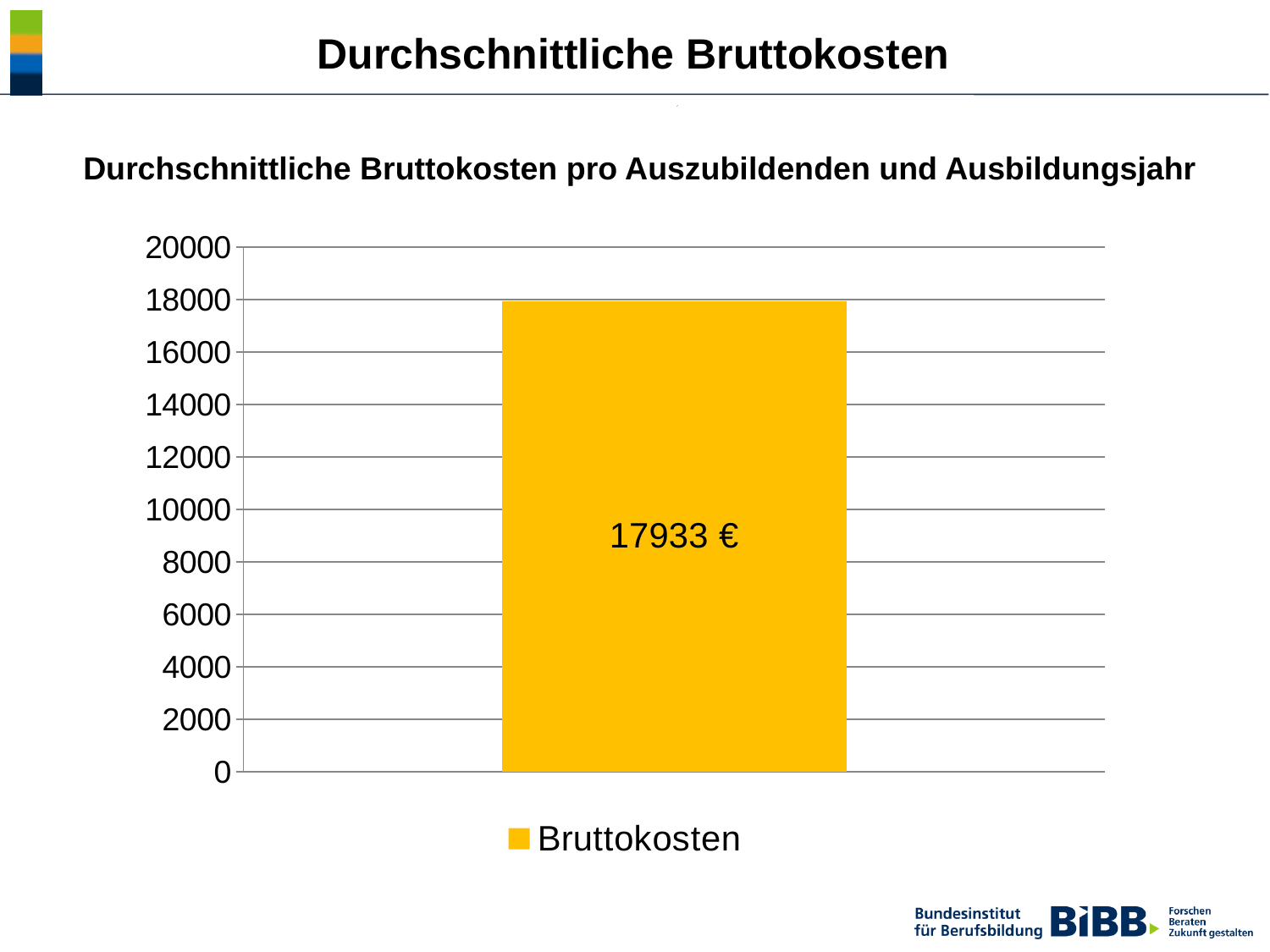
Is the value for Bruttokosten greater or less than 18000? less What series name is shown in the legend? Bruttokosten How many series does the legend list? 1 What kind of chart is shown on the slide? bar chart What is the title of the chart? Durchschnittliche Bruttokosten pro Auszubildenden und Ausbildungsjahr Is the value for Bruttokosten greater or less than 16000? greater What is the value of the Bruttokosten bar? 17933 € What is the maximum value shown on the y axis? 20000 How many bars are plotted in the chart? 1